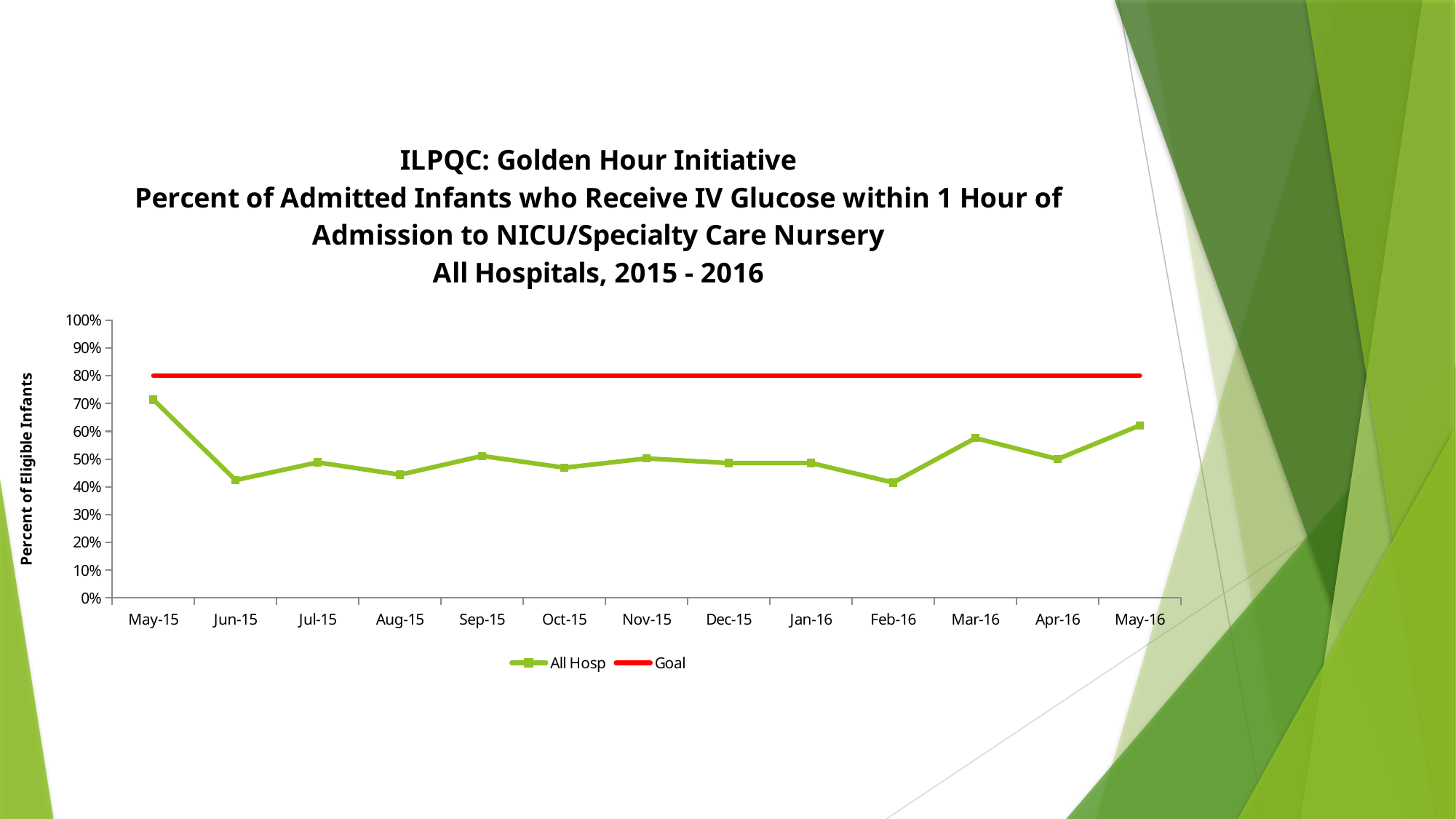
In which month is the All Hosp value highest? May-15 Which is larger, the All Hosp value for May-15 or for Jun-15? May-15 Is the All Hosp value for Feb-16 greater or less than 50%? less What value does the Goal line sit at? 80% Is the All Hosp value for Mar-16 greater or less than 50%? greater How many series does the legend list? 2 Does the All Hosp line rise or fall from May-15 to Jun-15? fall Is the All Hosp value for Jun-15 greater or less than 50%? less What kind of chart is shown on the slide? Line chart How many months are plotted along the x axis? 13 What is the label on the vertical axis? Percent of Eligible Infants